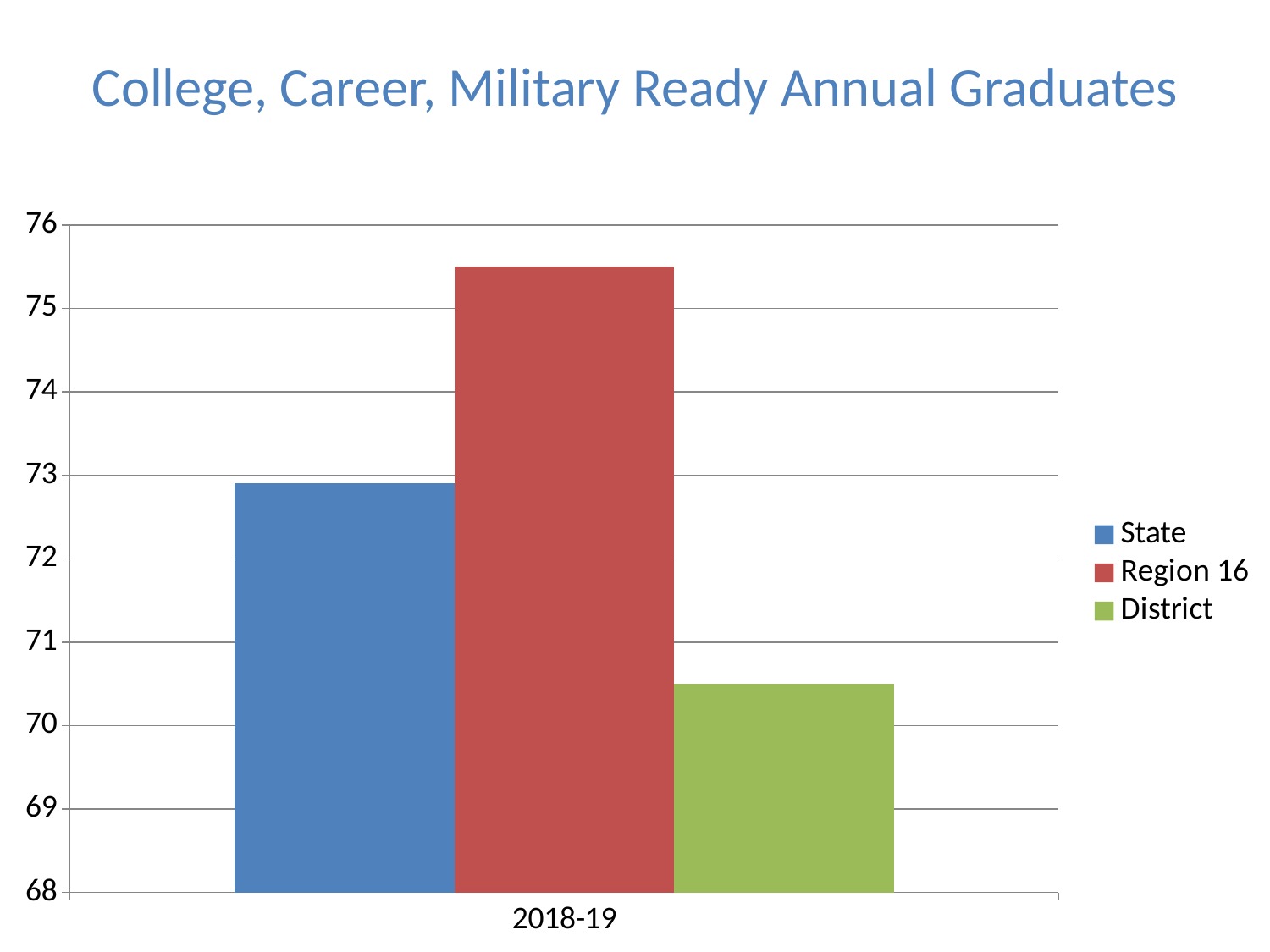
Which is larger for 2018-19, Region 16 or State? Region 16 Which is larger for 2018-19, State or District? State What is the title of the chart? College, Career, Military Ready Annual Graduates Is the value for District greater or less than 71? less How many categories are shown on the x axis? 1 Which series has the highest value for 2018-19? Region 16 How many series does the legend list? 3 What kind of chart is shown on the slide? bar chart Is the value for Region 16 greater or less than 75? greater Which series is shown in green? District Is the value for State greater or less than 73? less Which series has the lowest value for 2018-19? District